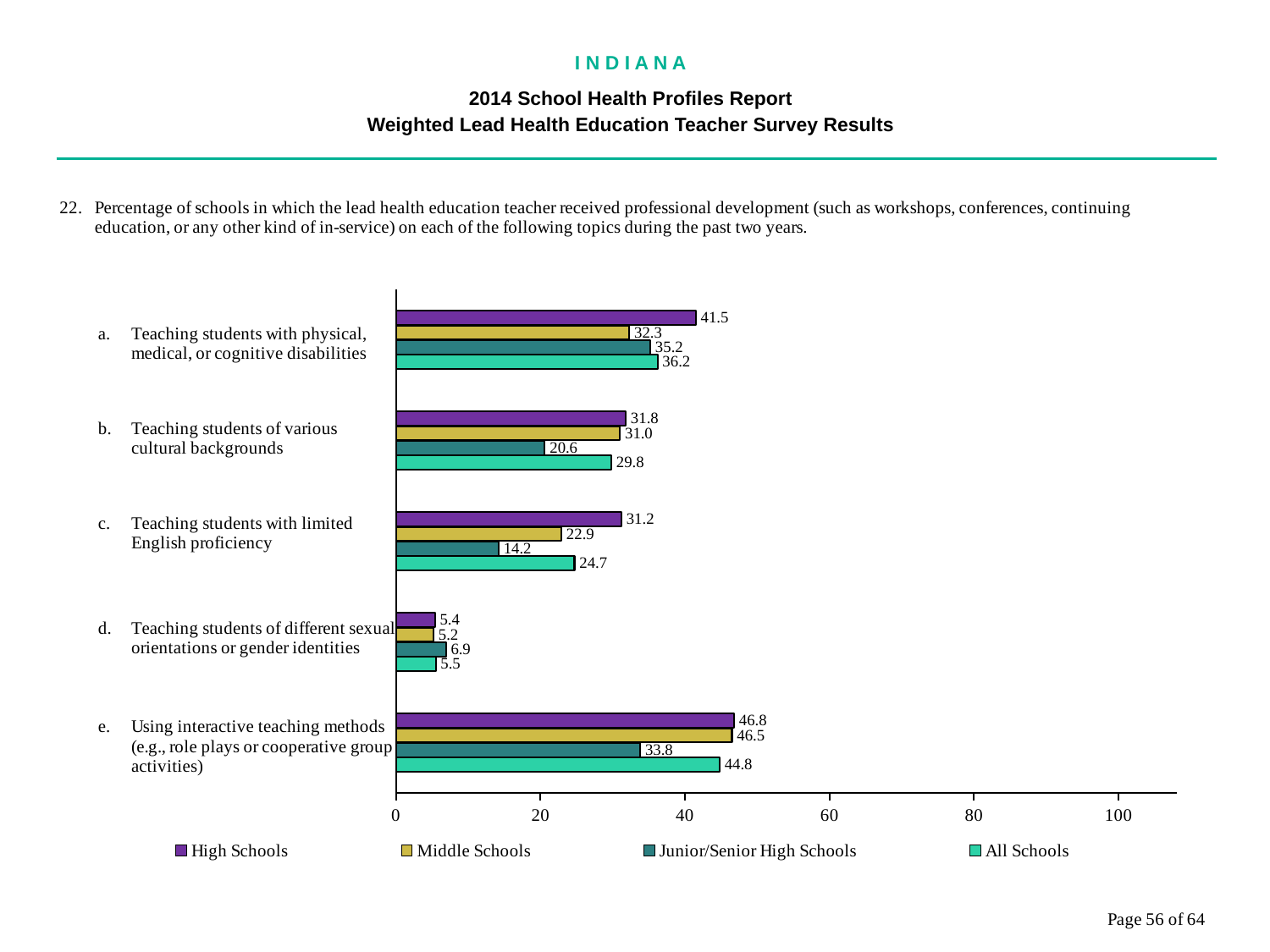
Which series is shown in purple in the legend? High Schools What is the value for All Schools for using interactive teaching methods? 44.8 How many series does the legend list? 4 Which topic has the lowest value for All Schools? Teaching students of different sexual orientations or gender identities How many topics are listed on the chart? 5 What is the value for High Schools for teaching students with physical, medical, or cognitive disabilities? 41.5 What is the value for Junior/Senior High Schools for teaching students with limited English proficiency? 14.2 Which topic has the highest value for Middle Schools? Using interactive teaching methods (e.g., role plays or cooperative group activities) Which is larger for teaching students of various cultural backgrounds: the Middle Schools value or the Junior/Senior High Schools value? Middle Schools What kind of chart is shown on the slide? Bar chart What is the difference between the High Schools and Middle Schools values for teaching students with physical, medical, or cognitive disabilities? 9.2 Is the High Schools value for using interactive teaching methods greater or less than 40? greater